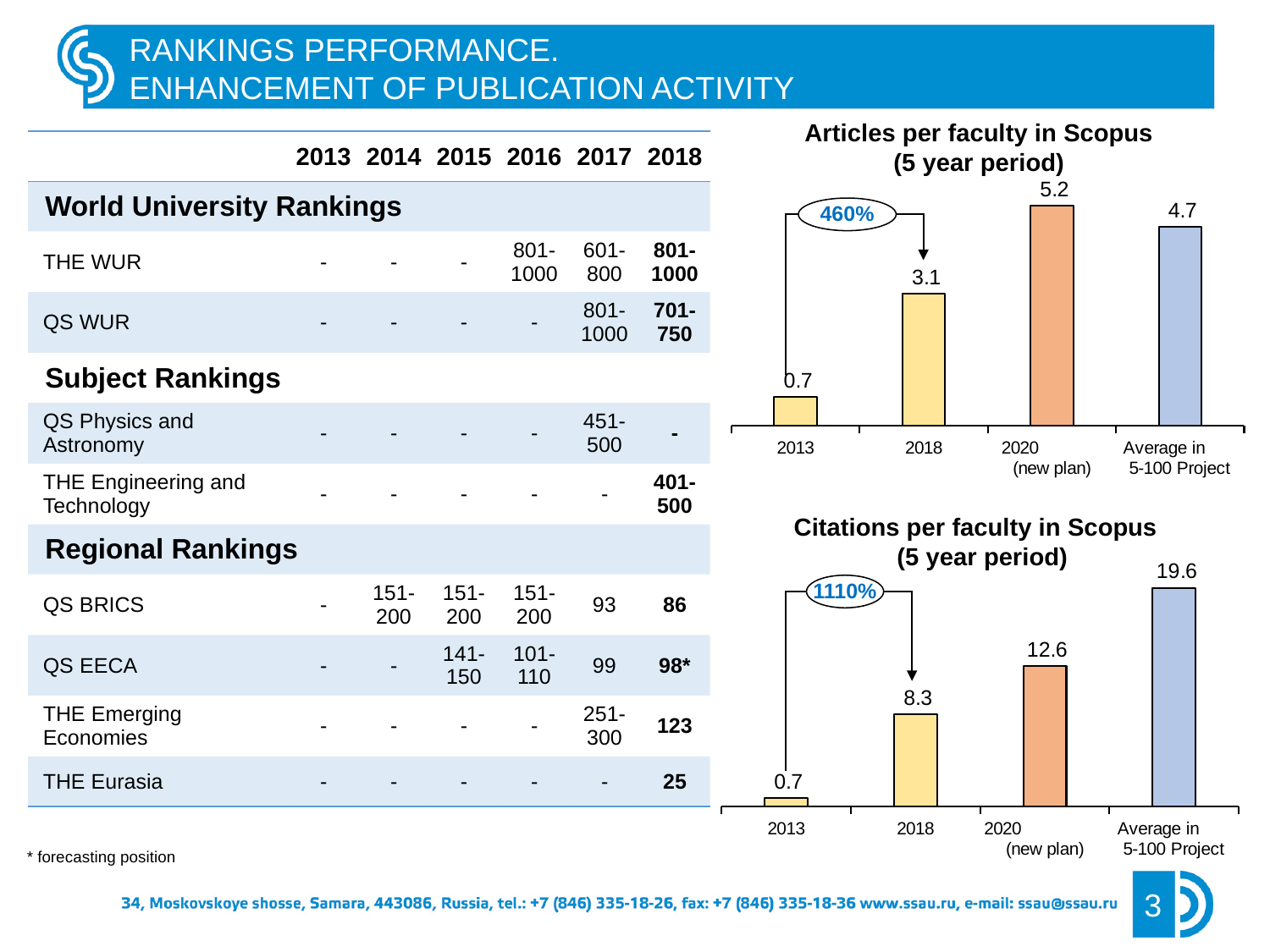
In the 'Citations per faculty in Scopus' chart, what is the difference between the Average in 5-100 Project value and the 2020 (new plan) value? 7.0 In the 'Articles per faculty in Scopus' chart, what is the difference between the 2020 (new plan) value and the Average in 5-100 Project value? 0.5 What type of chart is the 'Citations per faculty in Scopus' chart? Bar chart In the 'Articles per faculty in Scopus' chart, what percentage growth is shown in the callout between 2013 and 2018? 460% In the 'Citations per faculty in Scopus' chart, what is the value for Average in 5-100 Project? 19.6 In the 'Articles per faculty in Scopus' chart, what is the value for 2020 (new plan)? 5.2 In the 'Articles per faculty in Scopus' chart, which category has the highest value? 2020 (new plan) In the 'Citations per faculty in Scopus' chart, what is the value for 2018? 8.3 In the 'Citations per faculty in Scopus' chart, which is larger: the value for 2020 (new plan) or the value for Average in 5-100 Project? Average in 5-100 Project In the 'Articles per faculty in Scopus' chart, how many bars are plotted? 4 In the 'Articles per faculty in Scopus' chart, what is the value for 2018? 3.1 In the 'Citations per faculty in Scopus' chart, which category has the lowest value? 2013